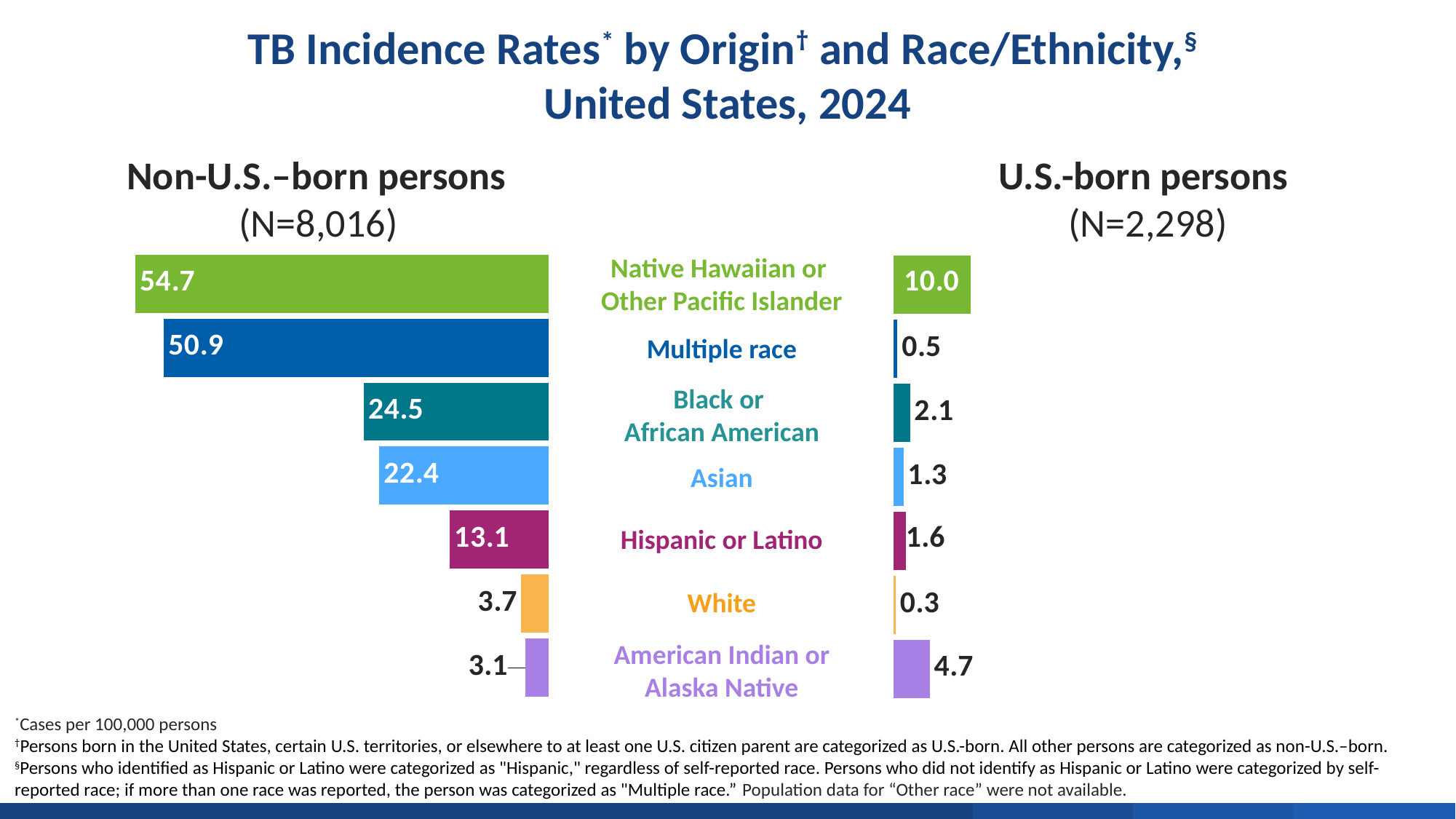
In the U.S.-born persons chart, which is larger: the rate for Hispanic or Latino persons or the rate for Asian persons? Hispanic or Latino In the U.S.-born persons chart, which race/ethnicity group has the lowest TB incidence rate? White How many race/ethnicity categories are shown in the Non-U.S.-born persons chart? 7 In the U.S.-born persons chart, what is the TB incidence rate for Multiple race persons? 0.5 In the U.S.-born persons chart, what is the difference between the rates for Native Hawaiian or Other Pacific Islander and American Indian or Alaska Native persons? 5.3 What type of chart is used to show the TB incidence rates for U.S.-born persons? Bar chart In the U.S.-born persons chart, what is the TB incidence rate for American Indian or Alaska Native persons? 4.7 In the Non-U.S.-born persons chart, what is the difference between the rates for Black or African American and Asian persons? 2.1 What is the N value shown for the Non-U.S.-born persons chart? N=8,016 In the Non-U.S.-born persons chart, which race/ethnicity group has the lowest TB incidence rate? American Indian or Alaska Native In the Non-U.S.-born persons chart, what is the TB incidence rate for Native Hawaiian or Other Pacific Islander persons? 54.7 In the U.S.-born persons chart, which race/ethnicity group has the highest TB incidence rate? Native Hawaiian or Other Pacific Islander